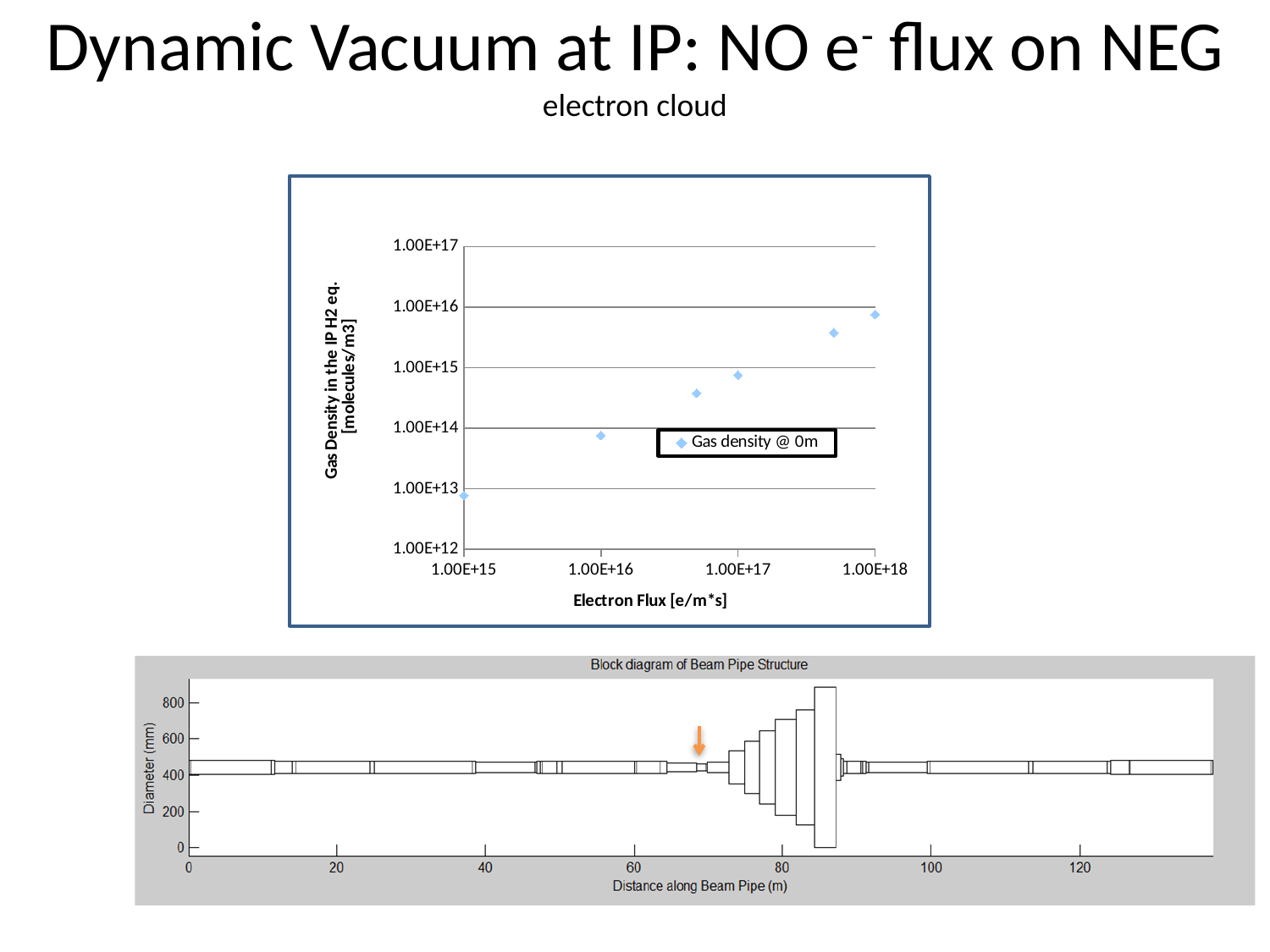
What is the title of the bottom chart? Block diagram of Beam Pipe Structure In the top chart, how many data points are plotted? 6 In the top chart, at which electron flux value is the gas density highest? 1.00E+18 In the top chart, is the gas density at an electron flux of 1.00E+15 greater or less than 1.00E+14? less In the top chart, is the gas density at an electron flux of 1.00E+17 greater or less than 1.00E+14? greater In the top chart, is the gas density at an electron flux of 1.00E+18 greater or less than 1.00E+15? greater In the top chart, at which electron flux value is the gas density lowest? 1.00E+15 In the top chart, which has the larger gas density: the point at 1.00E+16 or the point at 1.00E+17 electron flux? 1.00E+17 In the top chart, what is the legend entry for the plotted series? Gas density @ 0m What kind of chart is the top chart showing gas density versus electron flux? scatter chart In the top chart, does the gas density rise or fall as the electron flux increases along the x axis? rise In the top chart, how many series does the legend list? 1